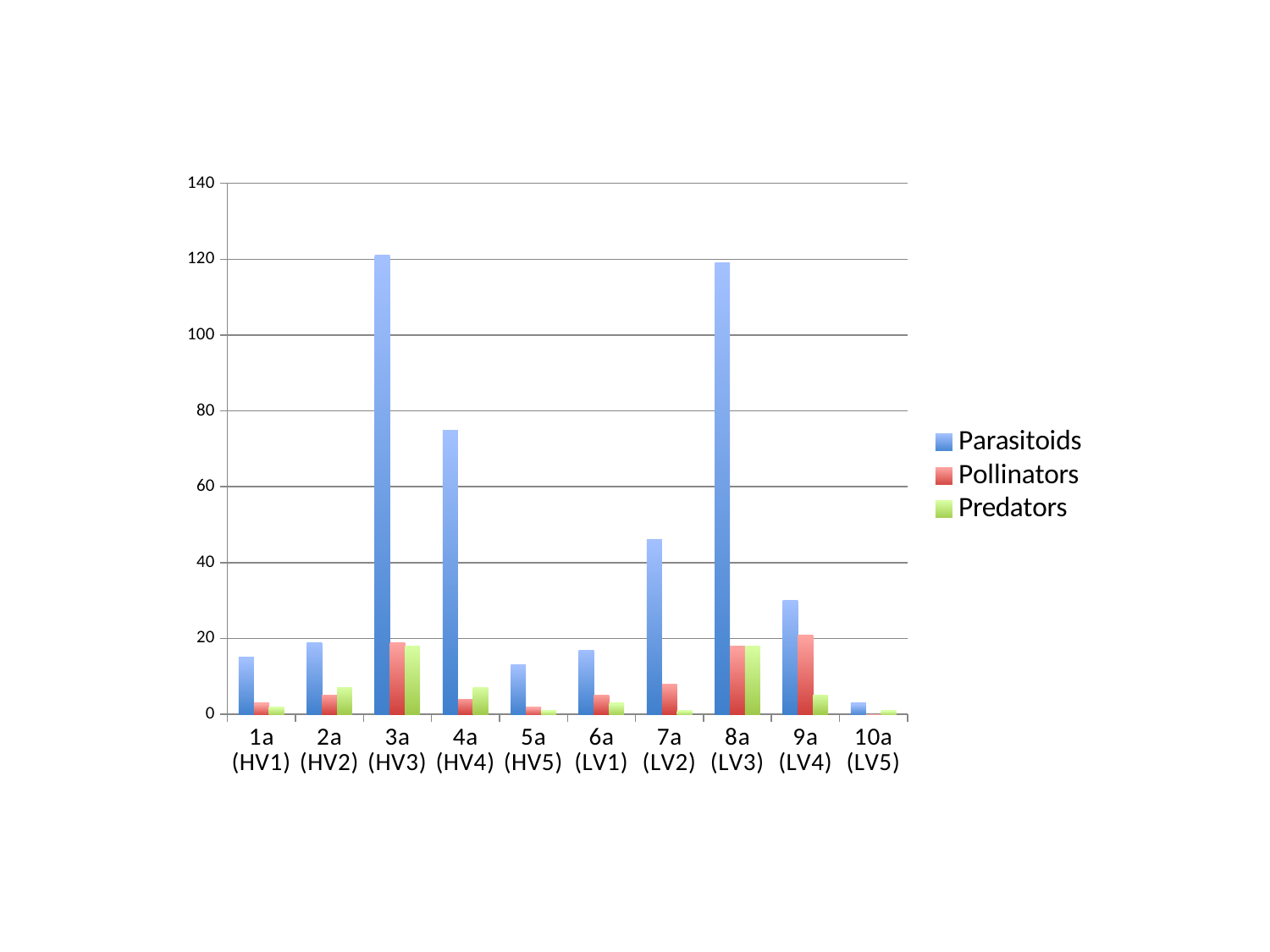
Is the Parasitoids value for 4a (HV4) greater or less than 60? greater How many series does the legend list? 3 Is the Predators value for 2a (HV2) greater or less than 20? less Is the Parasitoids value for 1a (HV1) greater or less than 20? less Which is larger, the Parasitoids value for 4a (HV4) or for 7a (LV2)? 4a (HV4) Which is larger, the Pollinators value for 9a (LV4) or for 1a (HV1)? 9a (LV4) What kind of chart is shown on the slide? bar chart Which series is shown in green? Predators Which category has the lowest Parasitoids value? 10a (LV5) How many categories are shown on the x axis? 10 Which category has the lowest Pollinators value? 10a (LV5)